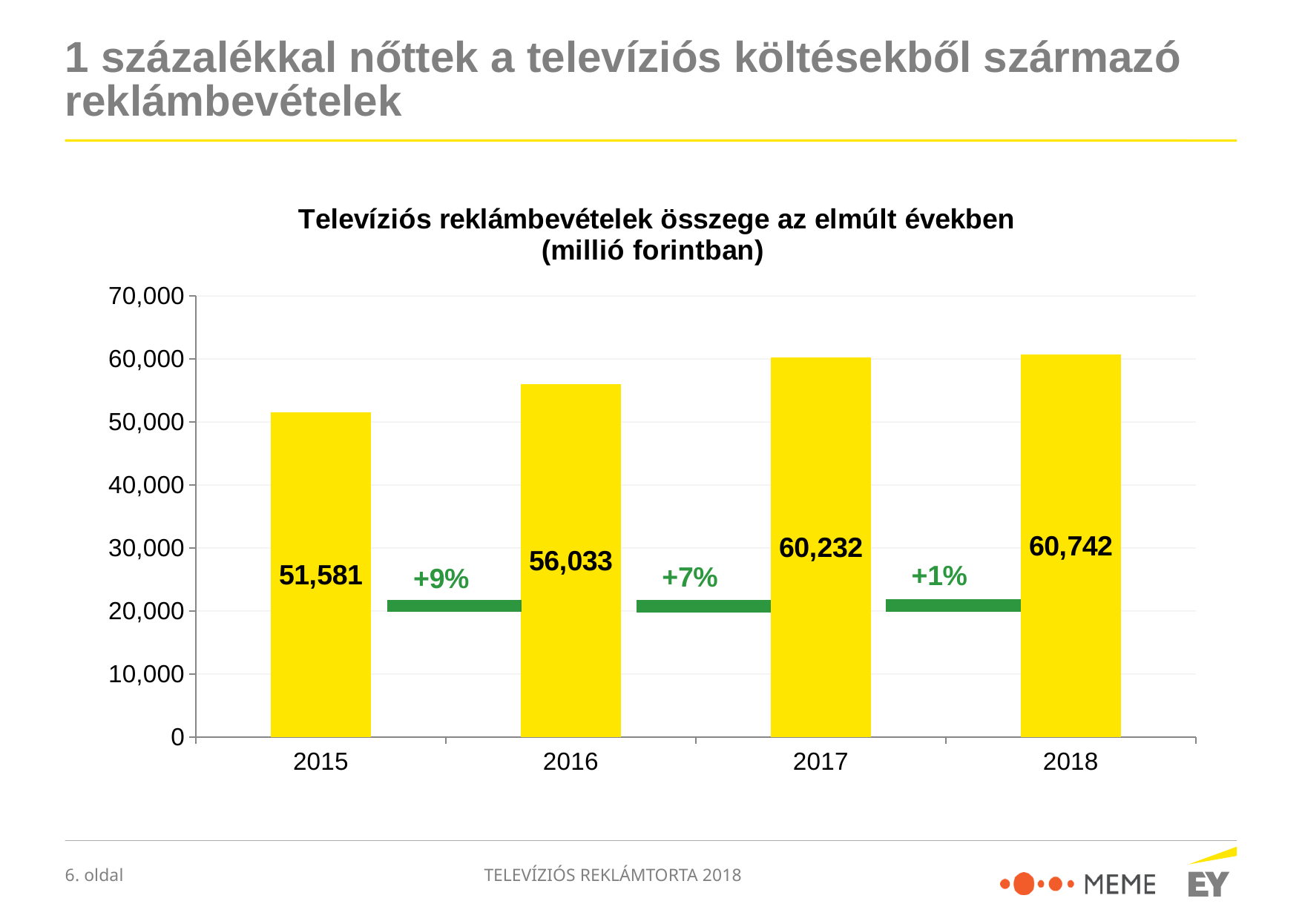
Do the values rise or fall from 2015 to 2018? rise Which year has the highest value? 2018 What is the value for 2018? 60,742 What is the difference between the values for 2018 and 2017? 510 How many years are shown on the x axis? 4 Is the value for 2015 greater or less than 50,000? greater What is the difference between the values for 2016 and 2015? 4,452 What is the value for 2016? 56,033 Which year has the lowest value? 2015 What is the value for 2015? 51,581 What kind of chart is shown? bar chart What is the value for 2017? 60,232